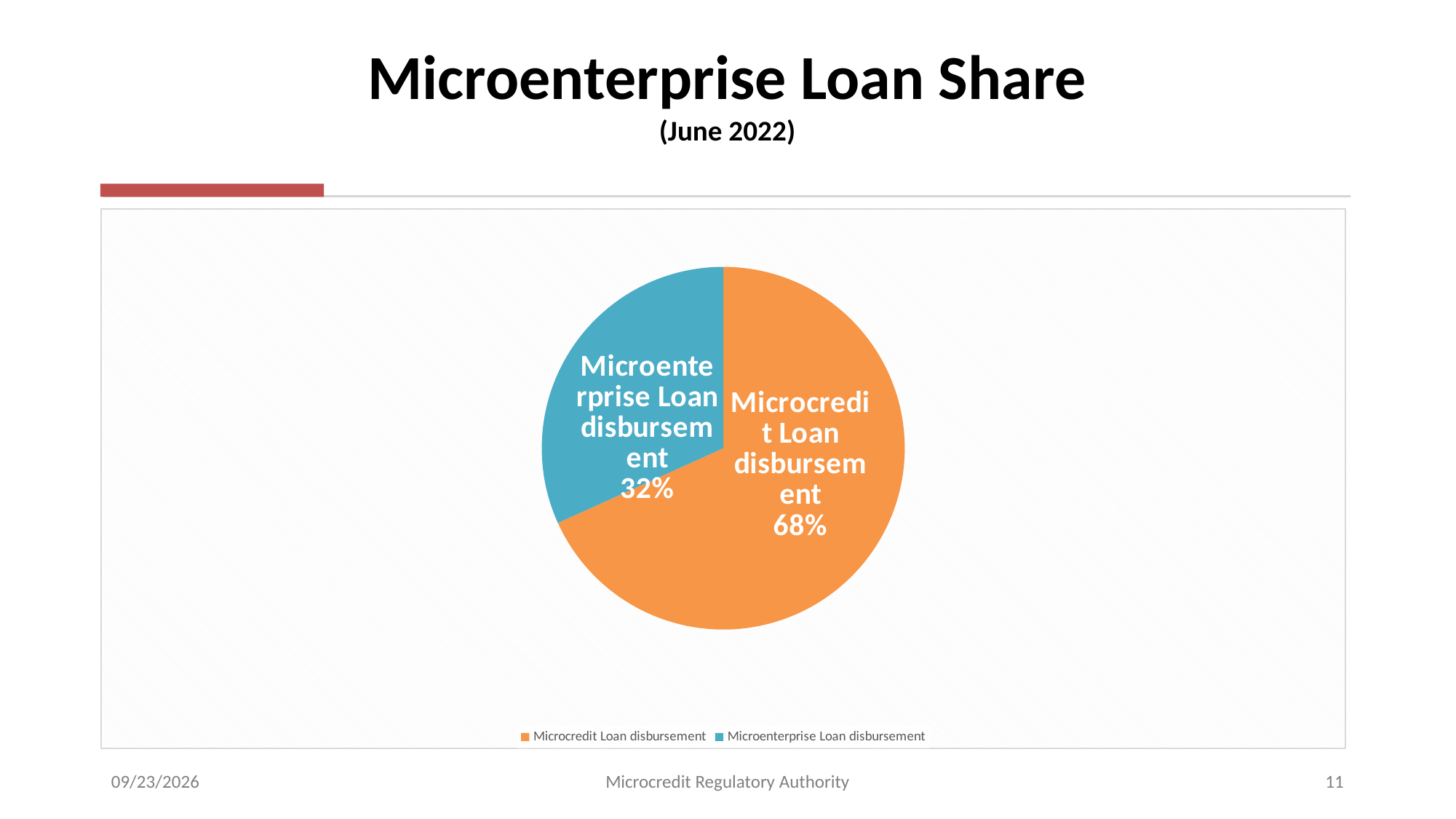
What share of the pie does Microcredit Loan disbursement have? 68% How many slices does the pie chart have? 2 How many entries does the legend list? 2 What is the title of the slide containing the chart? Microenterprise Loan Share (June 2022) What is the difference in percentage points between the Microcredit Loan disbursement share and the Microenterprise Loan disbursement share? 36 percentage points What colour is the Microenterprise Loan disbursement slice? Blue What share of the pie does Microenterprise Loan disbursement have? 32% What kind of chart is shown on the slide? Pie chart Which slice is the smallest? Microenterprise Loan disbursement Which is larger, the Microcredit Loan disbursement share or the Microenterprise Loan disbursement share? Microcredit Loan disbursement Which slice is the largest? Microcredit Loan disbursement